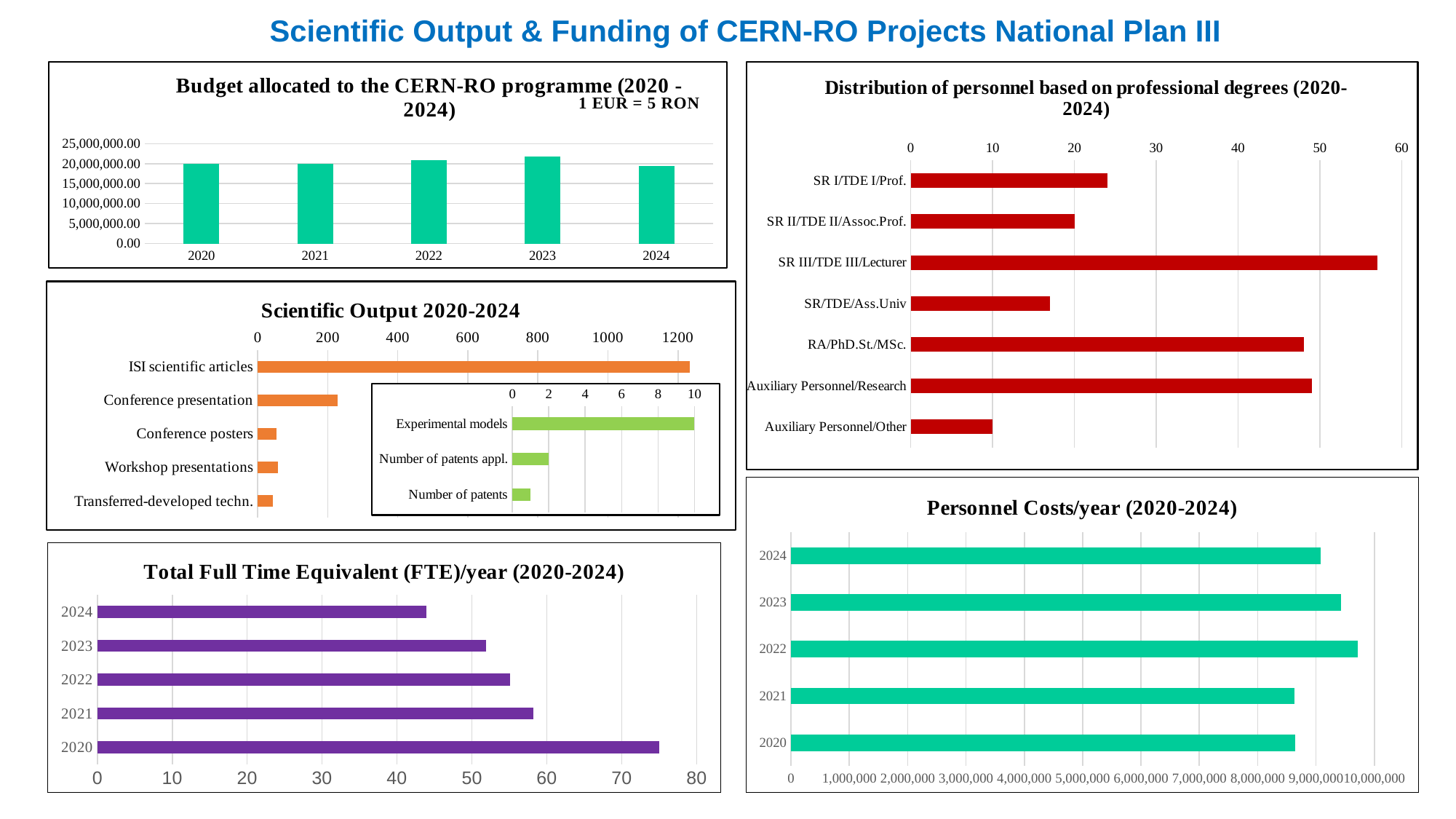
In the 'Total Full Time Equivalent (FTE)/year (2020-2024)' chart, which year has the highest FTE? 2020 In the 'Personnel Costs/year (2020-2024)' chart, is the value for 2022 greater or less than 9,000,000? greater In the 'Distribution of personnel based on professional degrees (2020-2024)' chart, how many categories are shown? 7 In the 'Total Full Time Equivalent (FTE)/year (2020-2024)' chart, do the values rise or fall from 2020 to 2024? fall In the 'Budget allocated to the CERN-RO programme (2020 - 2024)' chart, is the value for 2024 greater or less than 20,000,000.00? less What kind of chart is the 'Budget allocated to the CERN-RO programme (2020 - 2024)' chart? bar chart In the 'Budget allocated to the CERN-RO programme (2020 - 2024)' chart, which year has the highest budget? 2023 In the 'Distribution of personnel based on professional degrees (2020-2024)' chart, which category has the lowest value? Auxiliary Personnel/Other How many categories are shown in the main 'Scientific Output 2020-2024' chart (excluding the inset)? 5 In the 'Scientific Output 2020-2024' chart, is the value for Conference presentation greater or less than 200? greater In the 'Scientific Output 2020-2024' chart, which category has the highest value? ISI scientific articles